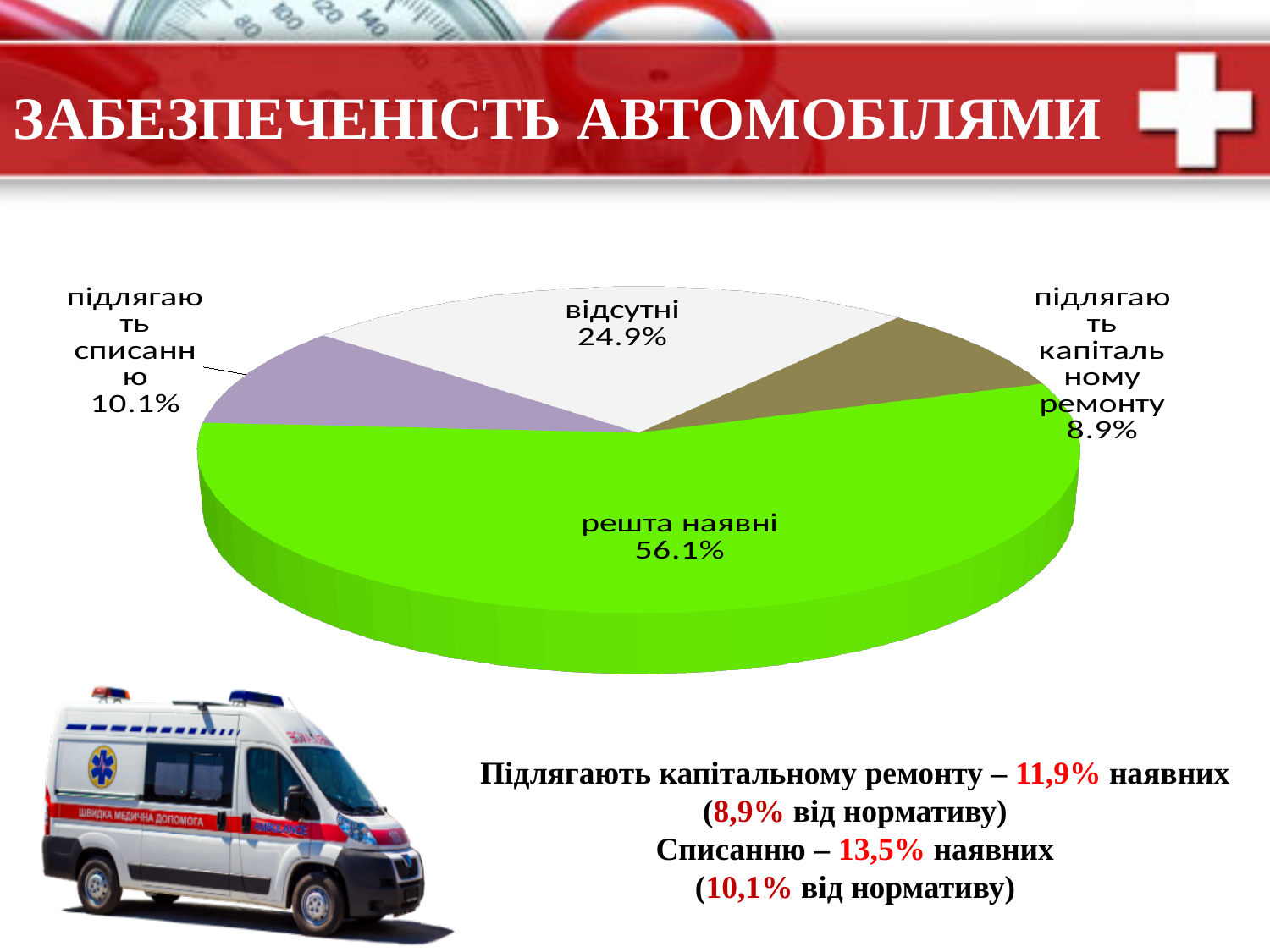
What is the difference in percentage points between "решта наявні" and "відсутні"? 31.2 What is the title of the slide containing the chart? ЗАБЕЗПЕЧЕНІСТЬ АВТОМОБІЛЯМИ What share of the pie does the slice "решта наявні" represent? 56.1% Which is larger: the slice for "відсутні" or the slice for "підлягають списанню"? відсутні What is the difference in percentage points between "підлягають списанню" and "підлягають капітальному ремонту"? 1.2 What type of chart is shown on the slide? pie chart Which slice of the pie chart is the smallest? підлягають капітальному ремонту How many slices does the pie chart have? 4 What percentage is shown for the slice "підлягають списанню"? 10.1% Which slice of the pie chart is the largest? решта наявні What percentage is shown for the slice "підлягають капітальному ремонту"? 8.9% What percentage is shown for the slice "відсутні"? 24.9%